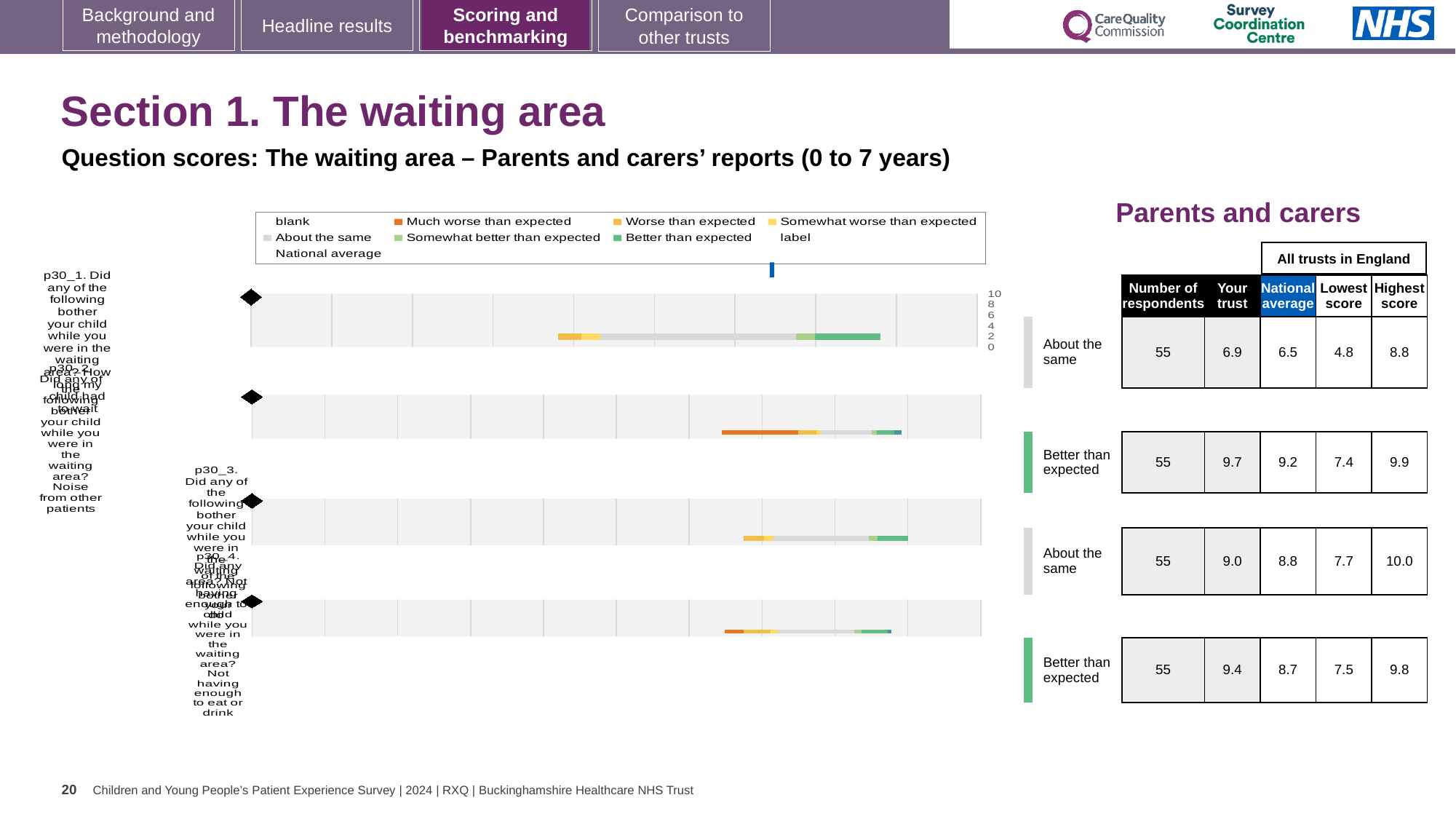
What kind of chart is shown on the slide? bar chart In the table beside the chart, what is the difference between the 'Your trust' score and the national average in the fourth row? 0.7 In the table beside the chart, what is the highest score for the third row (About the same)? 10.0 How many entries does the chart legend list? 9 In the table beside the chart, what is the 'Your trust' score for the first row (About the same)? 6.9 In the table beside the chart, what is the lowest score for the fourth row (Better than expected)? 7.5 Which legend entry is shown in dark green? Better than expected Which legend entry is shown in orange? Much worse than expected How many question rows (categories) does the chart show? 4 In the table beside the chart, what is the national average for the second row (Better than expected)? 9.2 In the table beside the chart, how many respondents are listed for each row? 55 In the table beside the chart, which row has the highest 'Your trust' score? Better than expected (9.7)